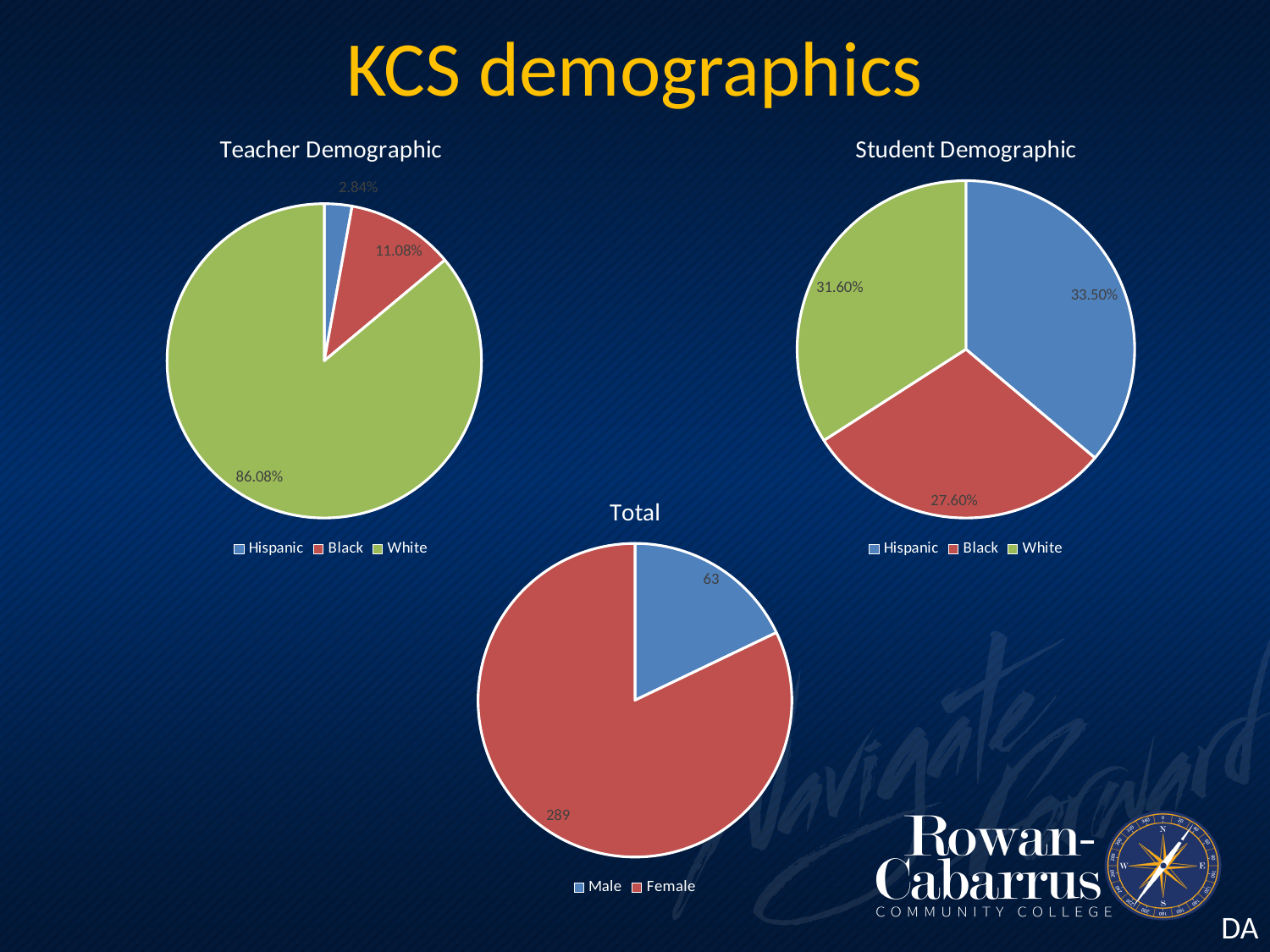
In the Total chart, what is the value for Female? 289 What type of chart is the Total chart? Pie chart In the Student Demographic chart, what percentage is Hispanic? 33.50% In the Student Demographic chart, what percentage is Black? 27.60% In the Teacher Demographic chart, which category has the largest share? White In the Student Demographic chart, which category has the smallest share? Black In the Total chart, what is the difference between the Female and Male values? 226 In the Total chart, what is the value for Male? 63 How many series does the legend of the Student Demographic chart list? 3 In the Teacher Demographic chart, what percentage is White? 86.08% In the Teacher Demographic chart, what percentage is Hispanic? 2.84% In the Teacher Demographic chart, what percentage is Black? 11.08%